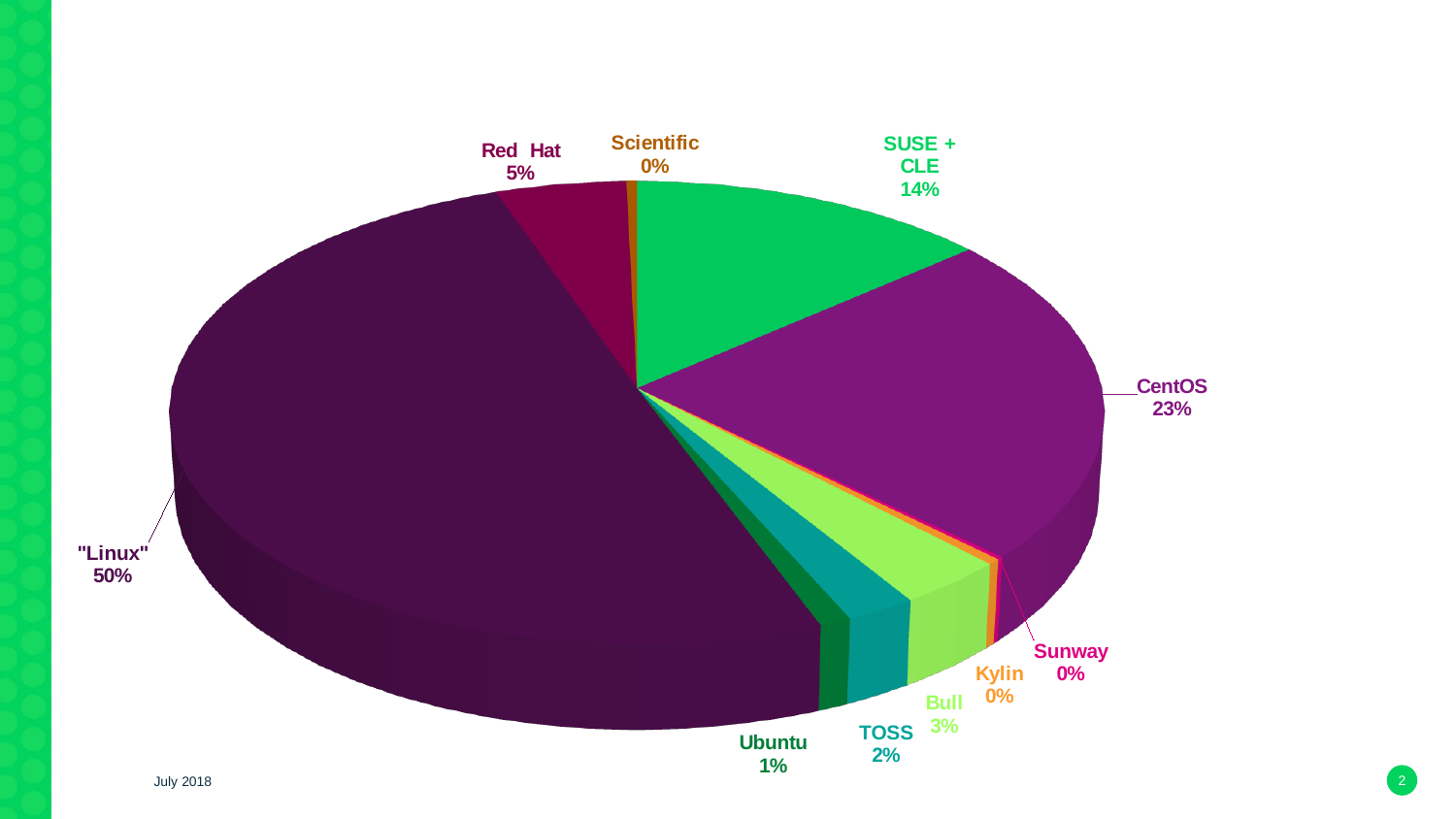
What share of the pie does TOSS have? 2% Which category has the largest slice of the pie? "Linux" What share of the pie does Ubuntu have? 1% What share of the pie does Bull have? 3% What date is printed at the bottom left of the slide? July 2018 What kind of chart is shown on the slide? pie chart Which is larger, the share for Red Hat or the share for Bull? Red Hat How many categories are labelled on the pie chart? 10 What share of the pie does Red Hat have? 5% What is the difference in percentage points between CentOS and SUSE + CLE? 9 What share of the pie does SUSE + CLE have? 14% What share of the pie does CentOS have? 23%